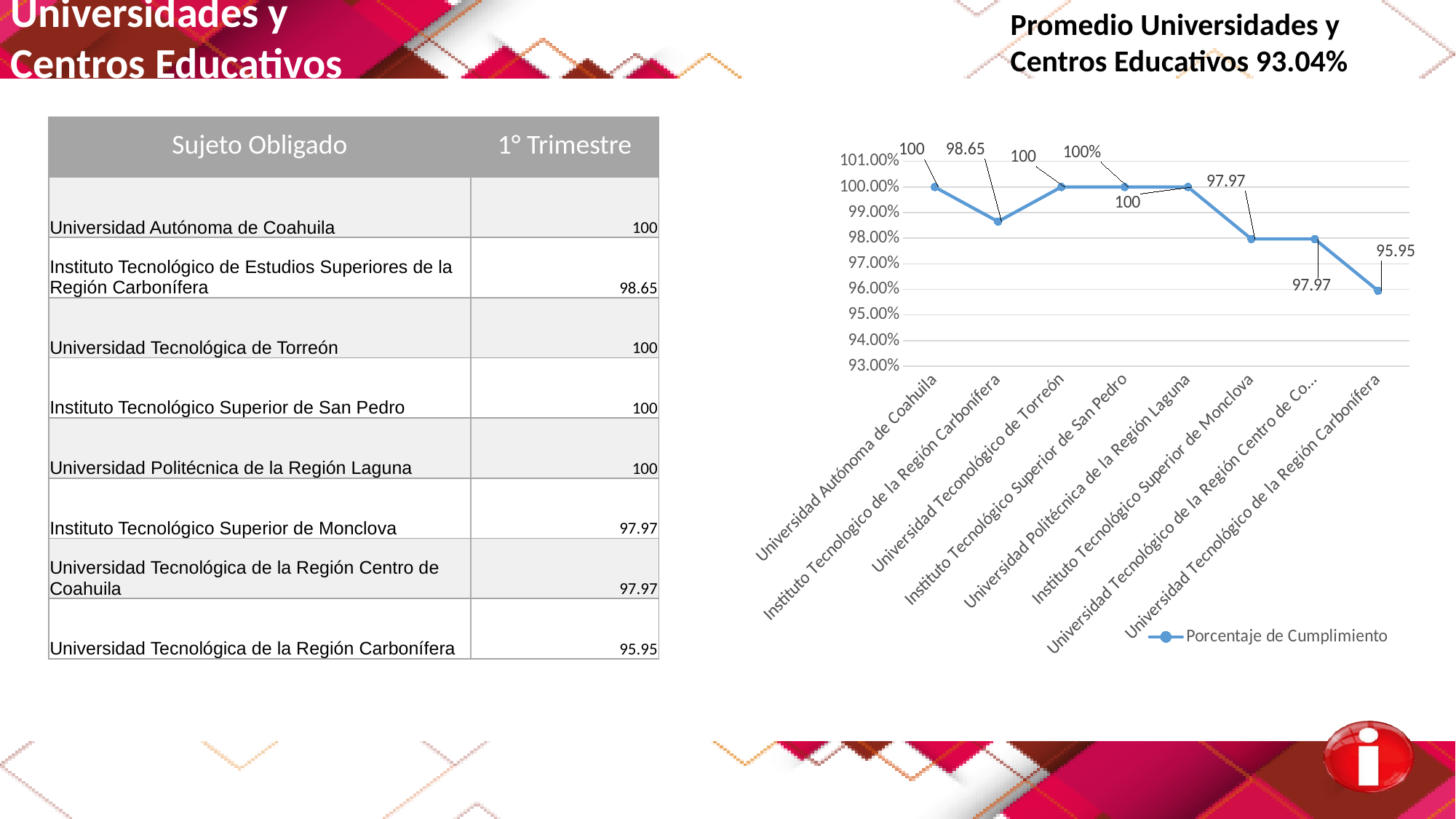
Which category has the lowest value in the line chart? Universidad Tecnológico de la Región Carbonífera Is the value for Universidad Tecnológico de la Región Carbonífera greater or less than 97.00%? less How many series does the legend of the line chart list? 1 Which is larger: the value for Instituto Tecnológico de la Región Carbonífera or the value for Instituto Tecnológico Superior de Monclova? Instituto Tecnológico de la Región Carbonífera What is the difference between the values for Instituto Tecnológico de la Región Carbonífera and Universidad Tecnológico de la Región Carbonífera? 2.70 What kind of chart is shown on the slide? Line chart What is the value for Universidad Autónoma de Coahuila in the line chart? 100 What is the value for Instituto Tecnológico Superior de Monclova in the line chart? 97.97 What is the value for Universidad Tecnológico de la Región Carbonífera in the line chart? 95.95 How many categories are plotted on the x axis of the line chart? 8 What is the difference between the values for Universidad Politécnica de la Región Laguna and Instituto Tecnológico Superior de Monclova? 2.03 What is the value for Instituto Tecnológico de la Región Carbonífera in the line chart? 98.65